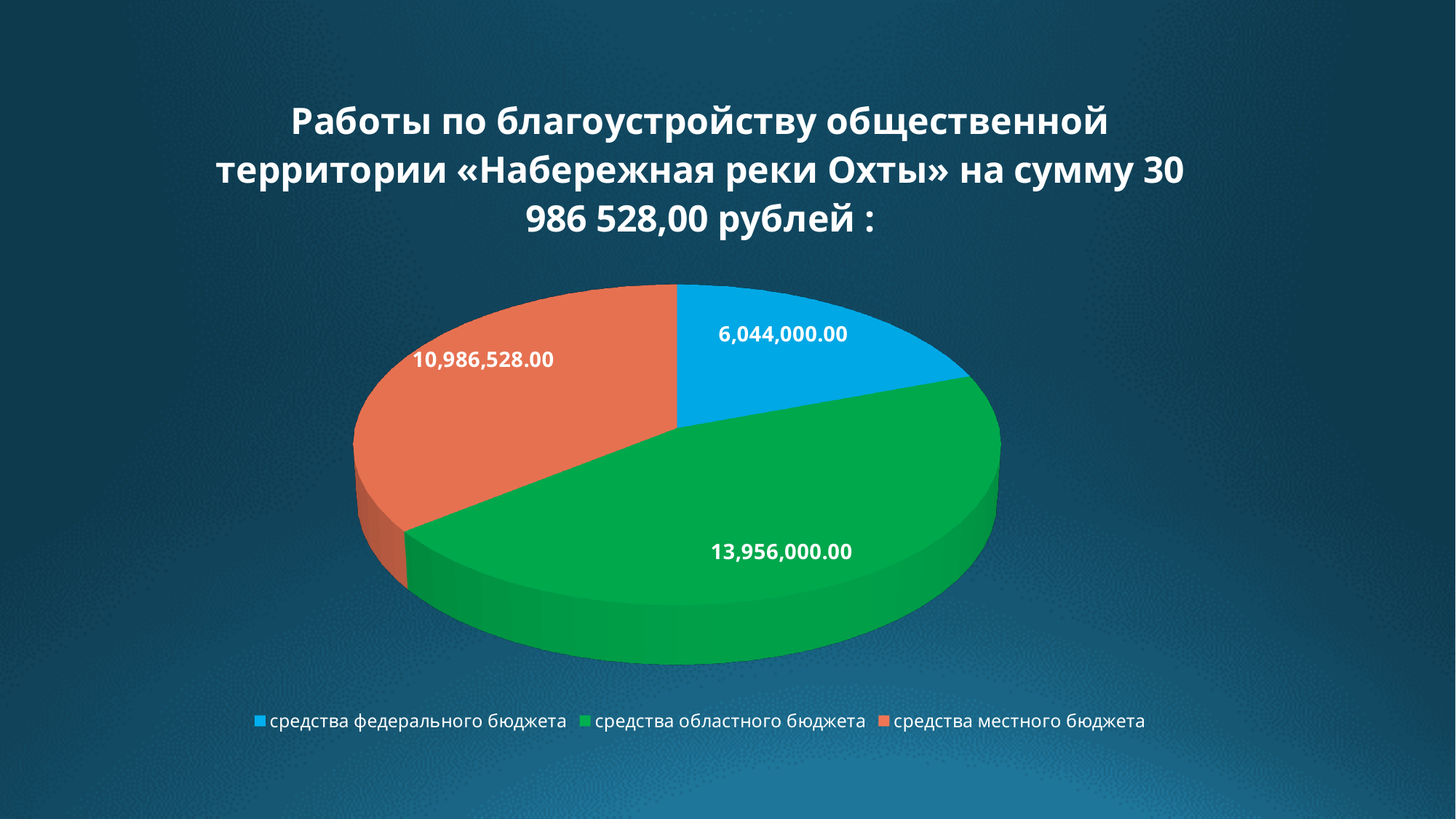
How many slices does the pie chart have? 3 Which budget source has the smallest slice of the pie? средства федерального бюджета What is the value for средства областного бюджета? 13,956,000.00 What is the difference between средства областного бюджета and средства федерального бюджета? 7,912,000.00 What is the value for средства местного бюджета? 10,986,528.00 What colour is the slice for средства областного бюджета? Green What is the difference between средства областного бюджета and средства местного бюджета? 2,969,472.00 What is the value for средства федерального бюджета? 6,044,000.00 Which budget source has the largest slice of the pie? средства областного бюджета How many entries does the legend list? 3 Which is larger, средства местного бюджета or средства федерального бюджета? средства местного бюджета What type of chart is shown on the slide? Pie chart